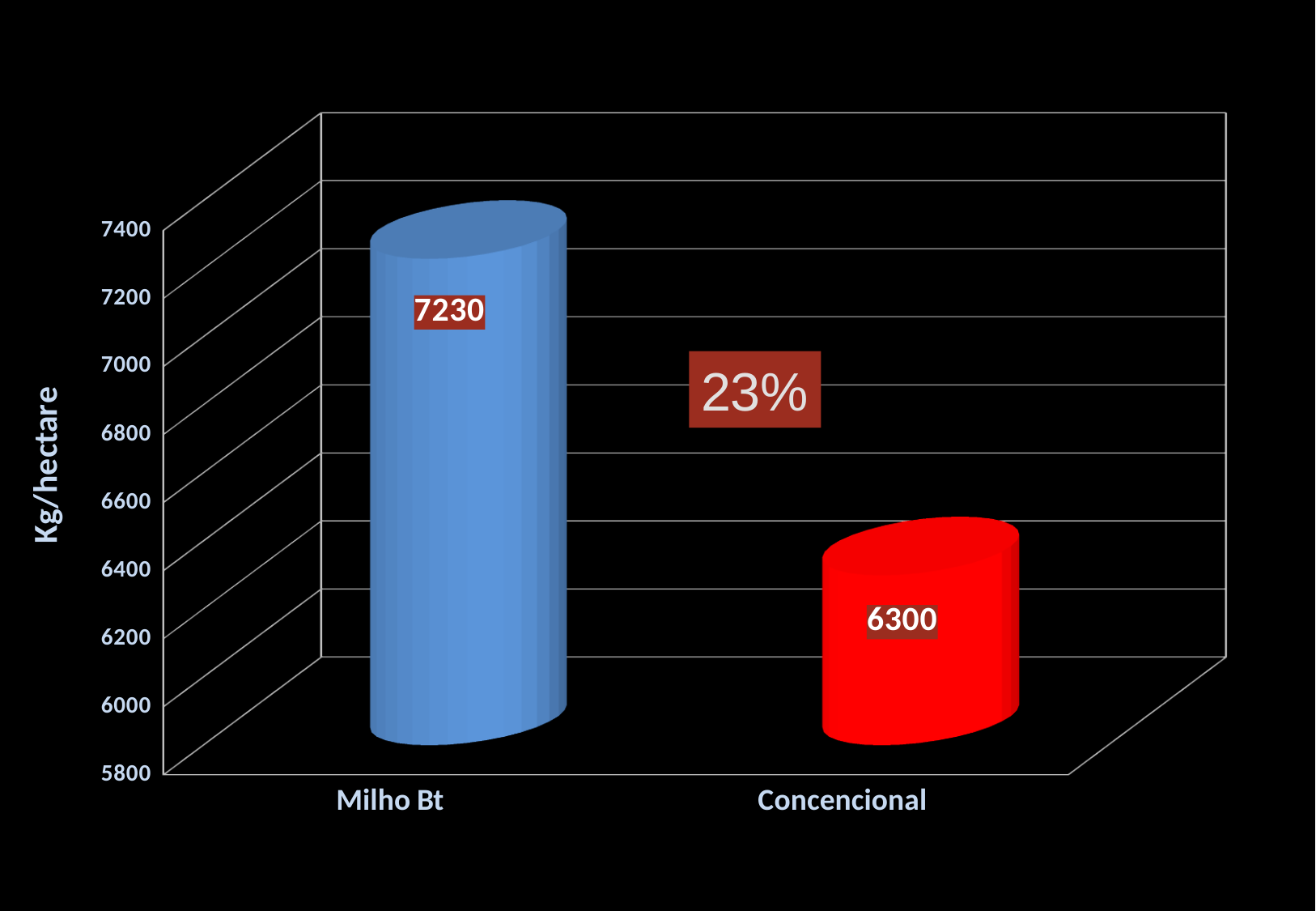
What kind of chart is shown on the slide? bar chart What is the difference between the values for Milho Bt and Concencional? 930 What is the value for Concencional? 6300 What percentage is shown in the box between the two bars? 23% Which category has the highest value? Milho Bt Is the value for Concencional greater or less than 6400? less What is the value for Milho Bt? 7230 Is the value for Milho Bt greater or less than 7000? greater How many categories are shown on the x axis? 2 What is the label of the vertical axis? Kg/hectare Which is larger, the value for Milho Bt or the value for Concencional? Milho Bt Which category has the lowest value? Concencional